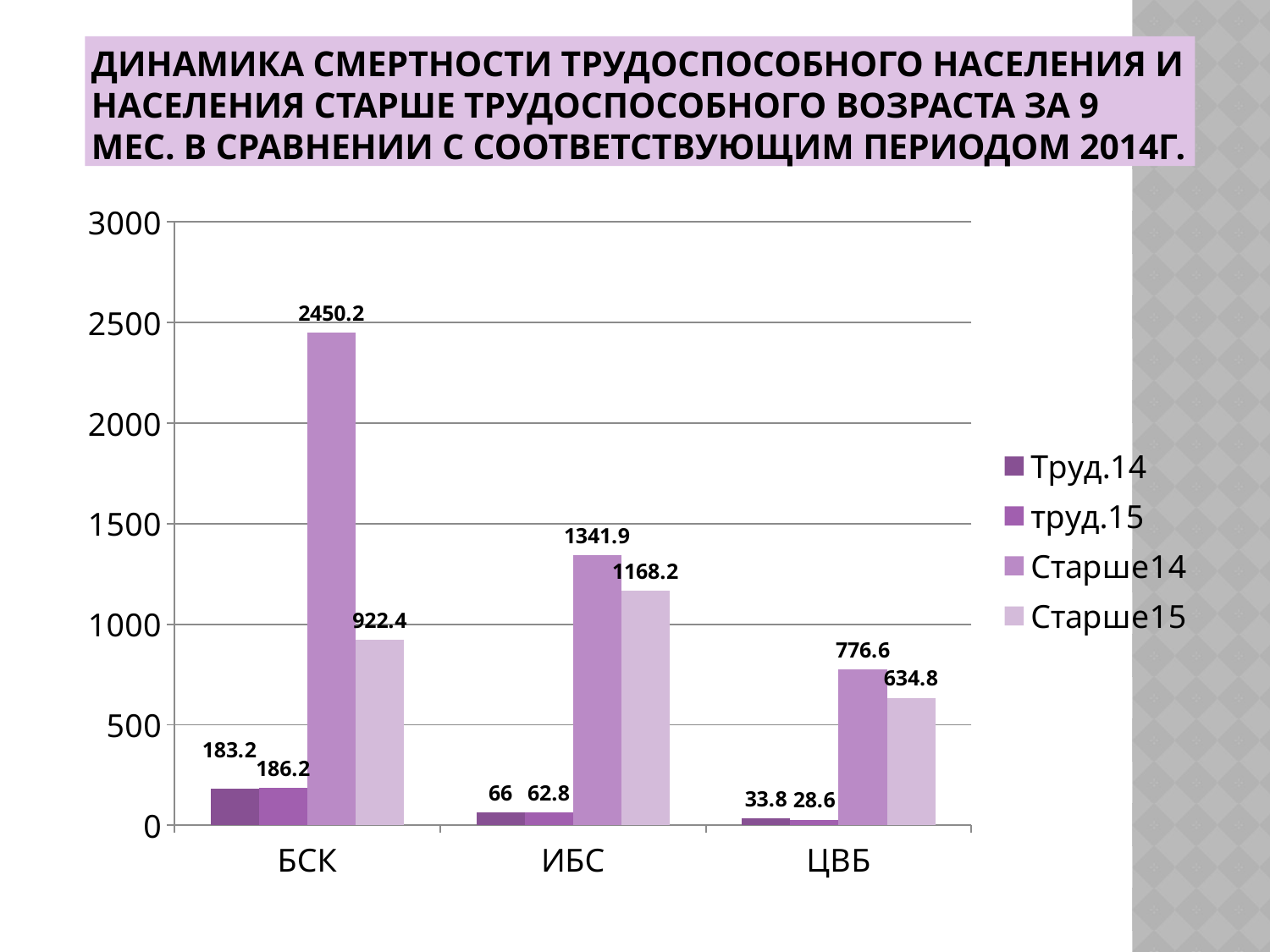
Is the value of Старше14 for ИБС greater or less than 1000? greater What is the value of Труд.14 for ИБС? 66 What is the difference between Старше14 and Старше15 for БСК? 1527.8 Which category has the highest value for Старше14? БСК Which is larger for ЦВБ: Старше14 or Старше15? Старше14 What is the value of труд.15 for ЦВБ? 28.6 Which category has the lowest value for Труд.14? ЦВБ What type of chart is shown on the slide? Bar chart How many categories are shown on the x axis? 3 How many series does the legend list? 4 What is the value of Старше15 for ИБС? 1168.2 What is the value of Старше14 for БСК? 2450.2